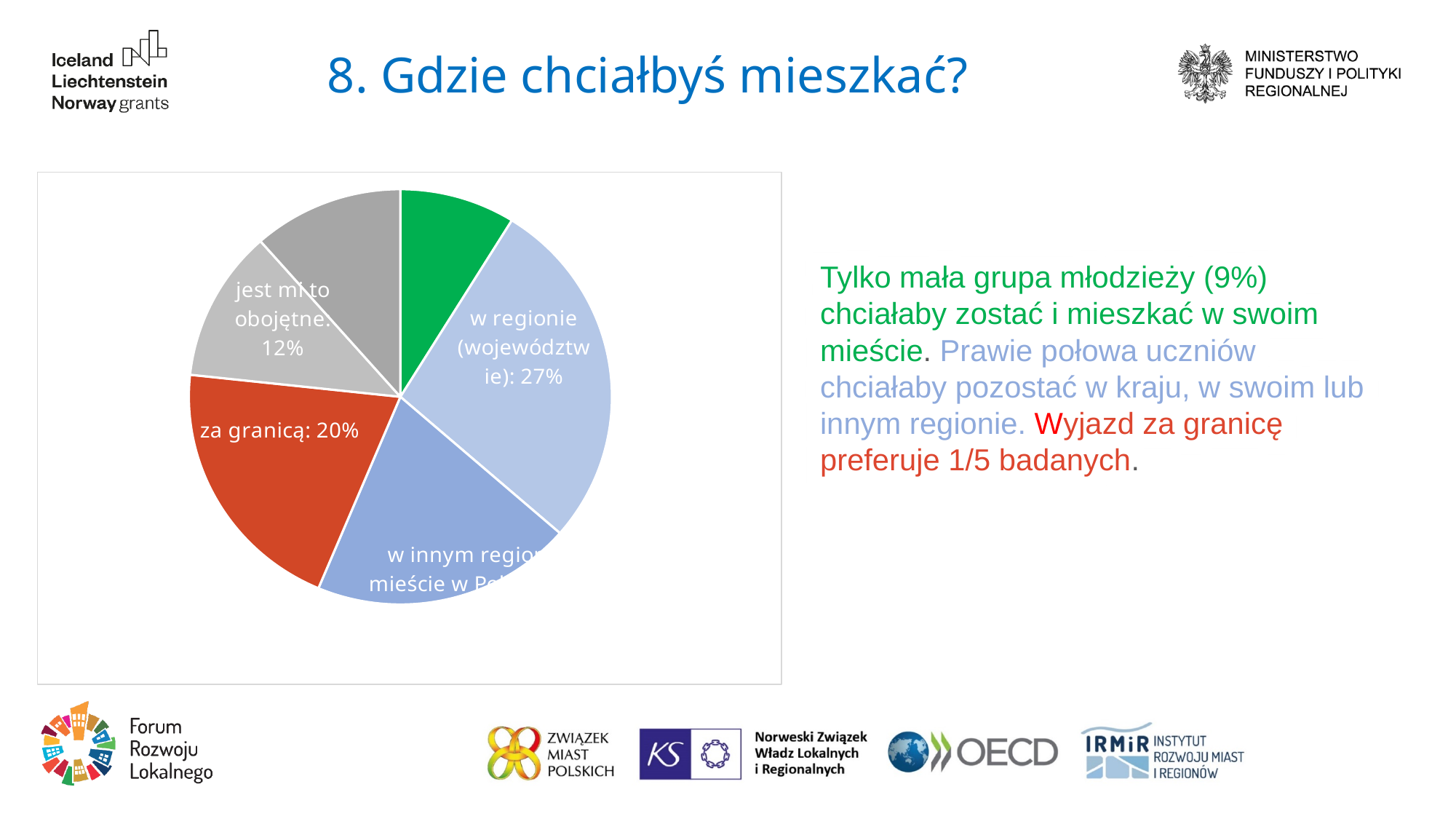
How many slices does the pie chart have? 6 What kind of chart is shown on the slide? pie chart What percentage of respondents chose "za granicą"? 20% What is the difference between the "za granicą" slice and the "jest mi to obojętne" slice? 8 percentage points Which slice is larger: "za granicą" or "jest mi to obojętne"? za granicą How many percentage points larger is the "w regionie (województwie)" slice than the "za granicą" slice? 7 percentage points What colour is the "jest mi to obojętne" slice? light grey What colour is the "za granicą" slice? red What percentage of respondents chose "w regionie (województwie)"? 27% Which slice is larger: "w regionie (województwie)" or "za granicą"? w regionie (województwie) What percentage of respondents chose "jest mi to obojętne"? 12%